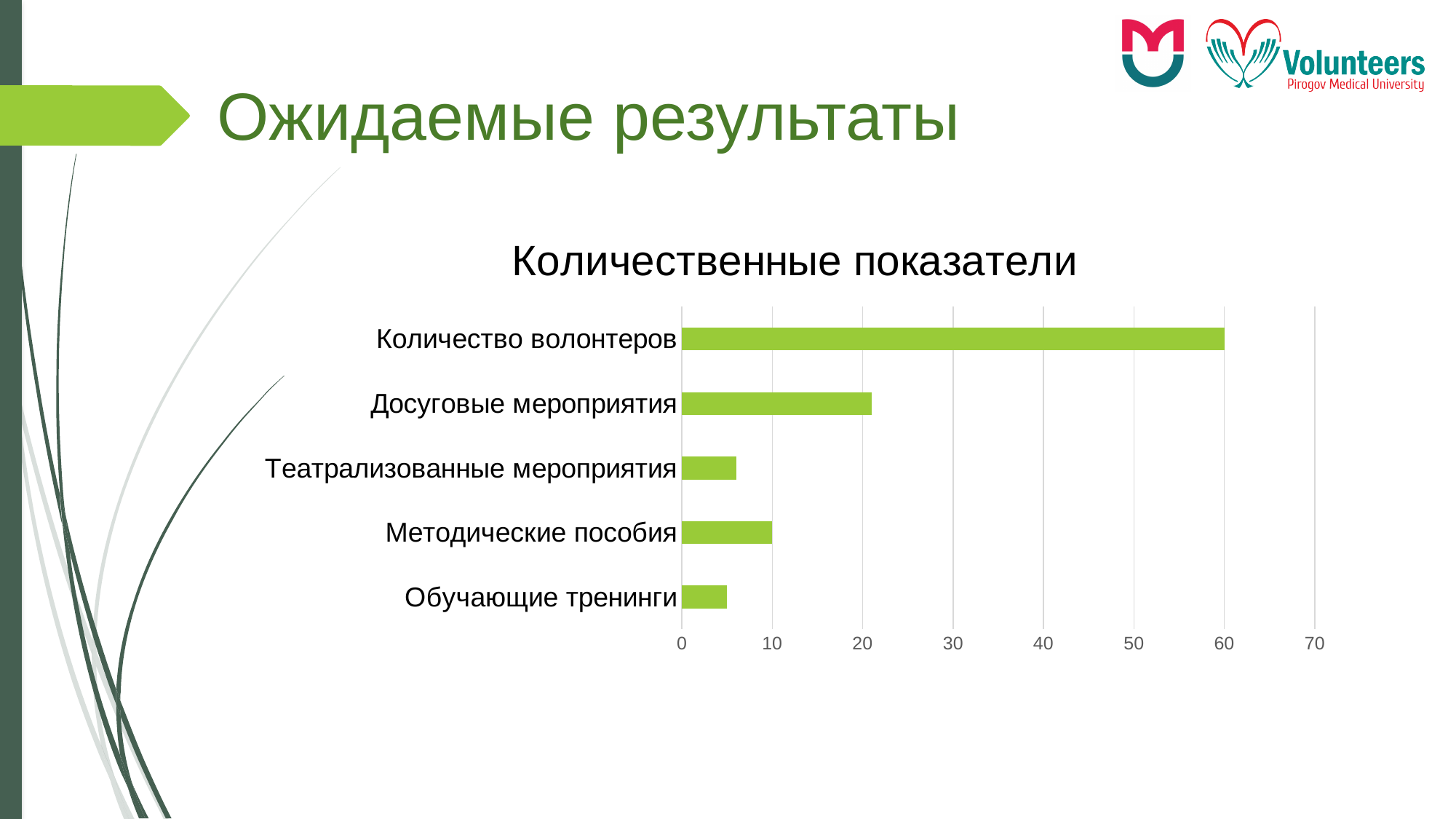
How many categories are shown in the chart? 5 What is the difference between the values for Количество волонтеров and Методические пособия? 50 Which is larger, the value for Досуговые мероприятия or the value for Методические пособия? Досуговые мероприятия Which is larger, the value for Количество волонтеров or the value for Досуговые мероприятия? Количество волонтеров Which category has the highest value? Количество волонтеров What kind of chart is shown on the slide? bar chart Is the value for Театрализованные мероприятия greater or less than 10? less What is the value for Методические пособия? 10 What is the title of the chart? Количественные показатели Is the value for Обучающие тренинги greater or less than 10? less What is the value for Количество волонтеров? 60